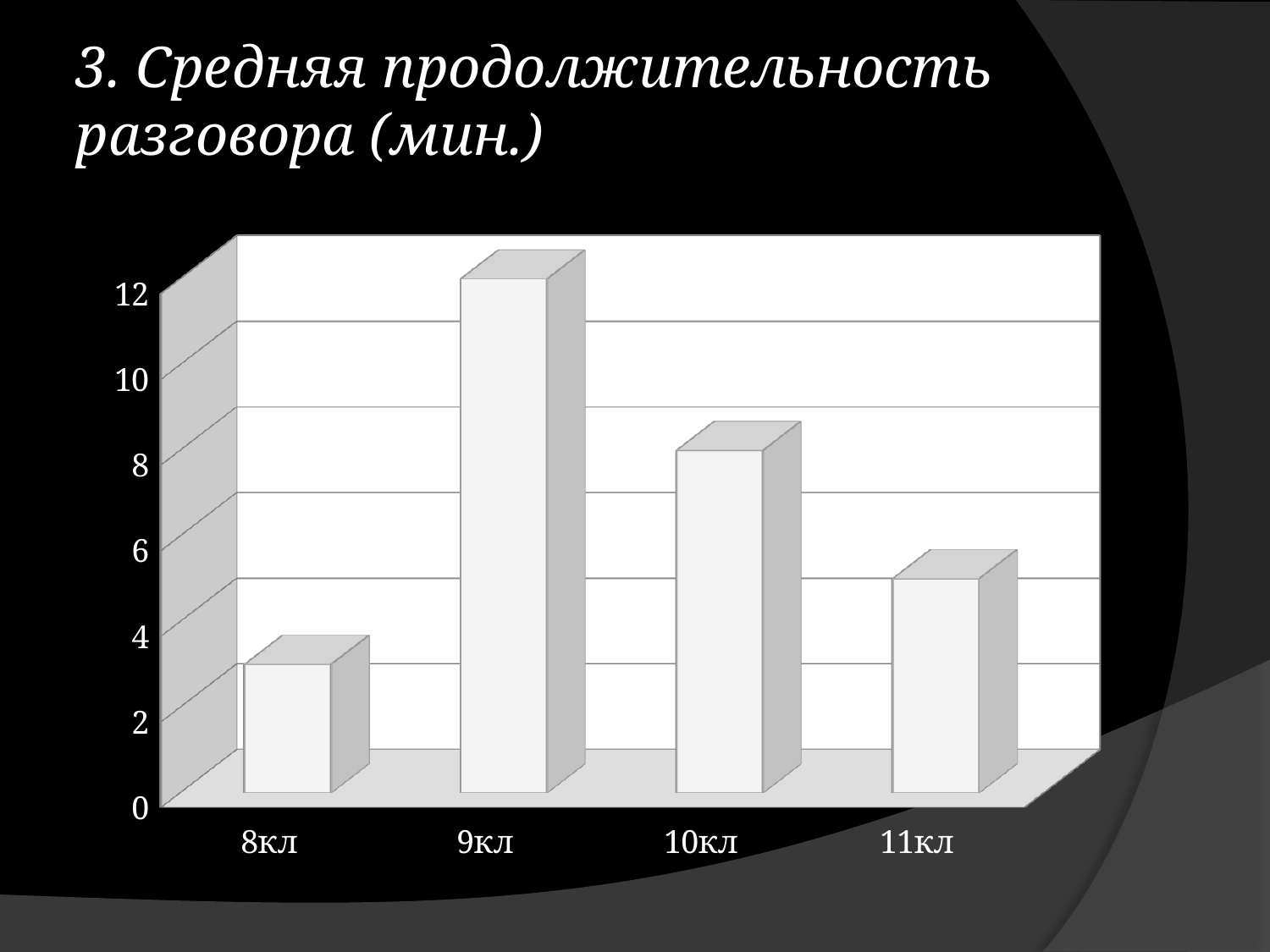
Is the value for 11кл greater or less than 4? greater Which category has the highest value? 9кл How many categories are plotted on the chart? 4 Which category has the lowest value? 8кл Is the value for 9кл greater or less than 10? greater Is the value for 8кл greater or less than 4? less What kind of chart is shown on the slide? bar chart Which is larger, the value for 8кл or the value for 11кл? 11кл What is the title of the slide above the chart? 3. Средняя продолжительность разговора (мин.) Which is larger, the value for 10кл or the value for 11кл? 10кл Do the values rise or fall from 9кл to 11кл? fall